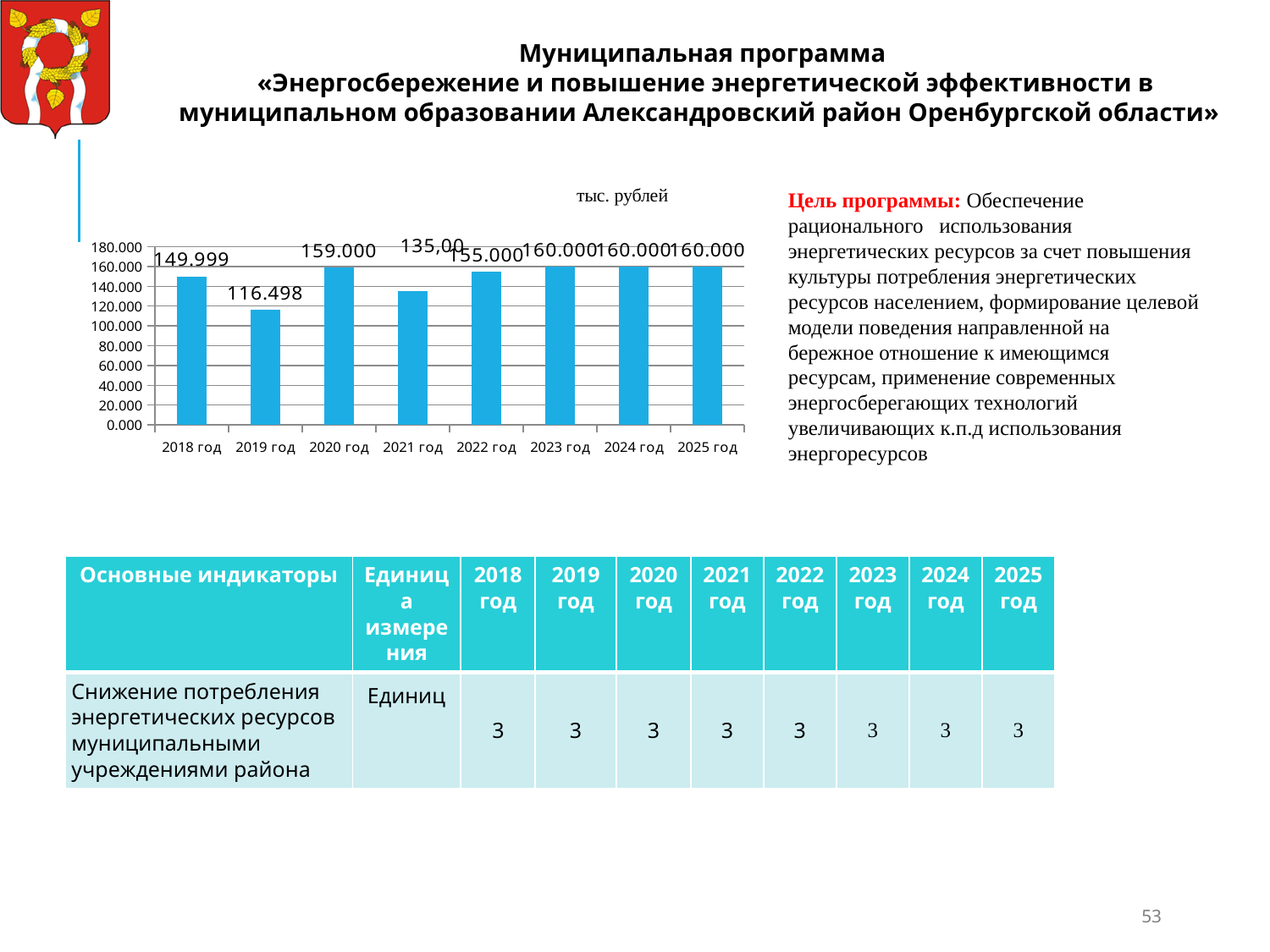
What is the value for 2022 год in the bar chart? 155.000 How many years are shown on the x axis of the bar chart? 8 What is the difference between the values for 2020 год and 2022 год in the bar chart? 4.000 What unit label is shown above the bar chart? тыс. рублей Is the value for 2021 год in the bar chart greater or less than 160.000? less What is the value for 2023 год in the bar chart? 160.000 What is the value for 2020 год in the bar chart? 159.000 Which year has the lowest value in the bar chart? 2019 год What is the value for 2018 год in the bar chart? 149.999 What is the value for 2019 год in the bar chart? 116.498 Which is larger in the bar chart, the value for 2018 год or for 2019 год? 2018 год What kind of chart is shown on the slide? bar chart